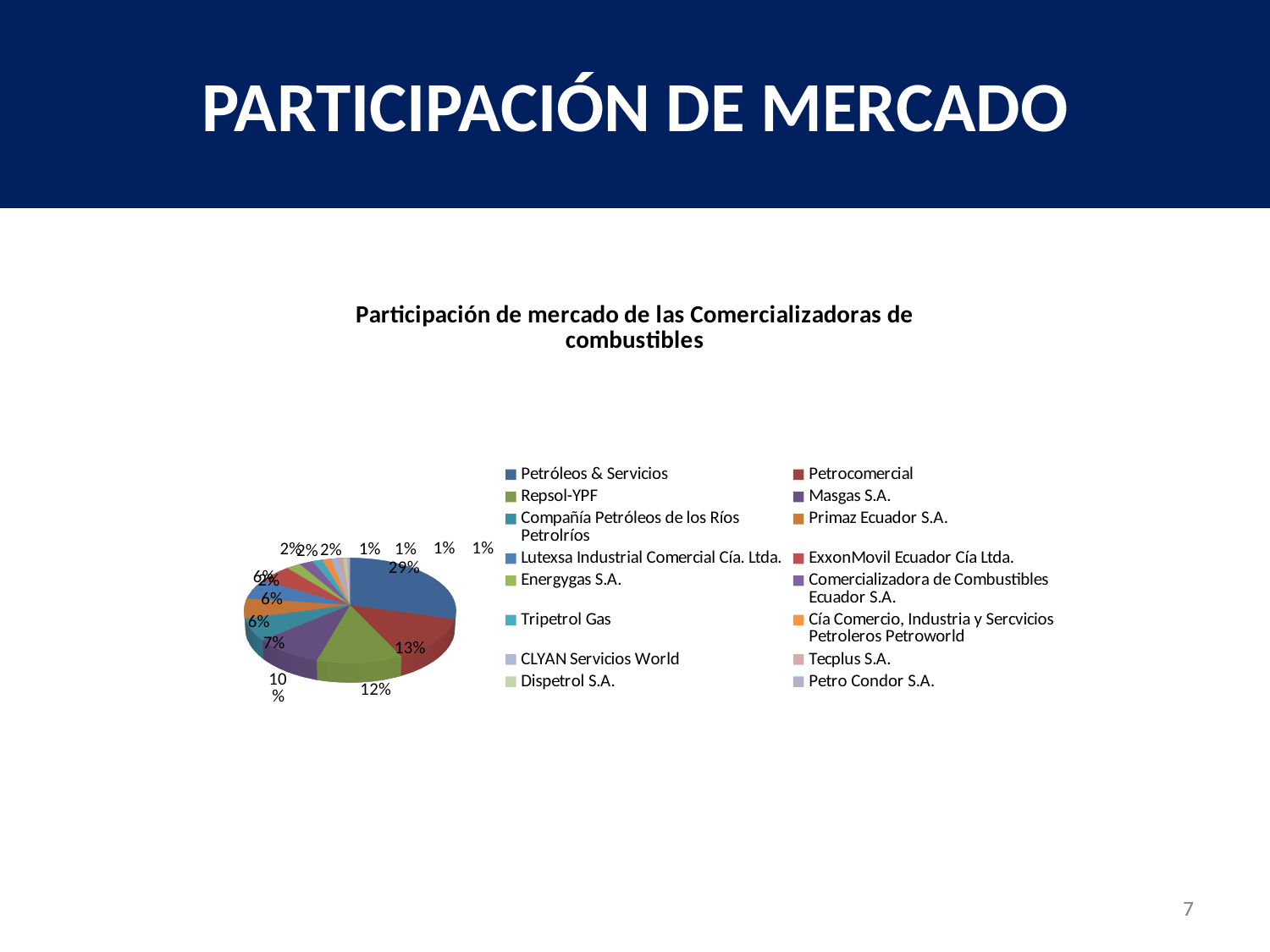
What share of the market does Repsol-YPF hold? 12% How many companies are listed in the chart's legend? 16 Which has a larger market share, Petróleos & Servicios or Masgas S.A.? Petróleos & Servicios What share of the market does Masgas S.A. hold? 10% How many percentage points larger is the share of Petróleos & Servicios than that of Petrocomercial? 16 What share of the market does Petróleos & Servicios hold? 29% Which has a larger market share, Petrocomercial or Repsol-YPF? Petrocomercial Which company is listed first in the chart's legend? Petróleos & Servicios What kind of chart is shown on the slide? Pie chart What is the title of the chart? Participación de mercado de las Comercializadoras de combustibles Which company has the largest share of the market in the pie chart? Petróleos & Servicios